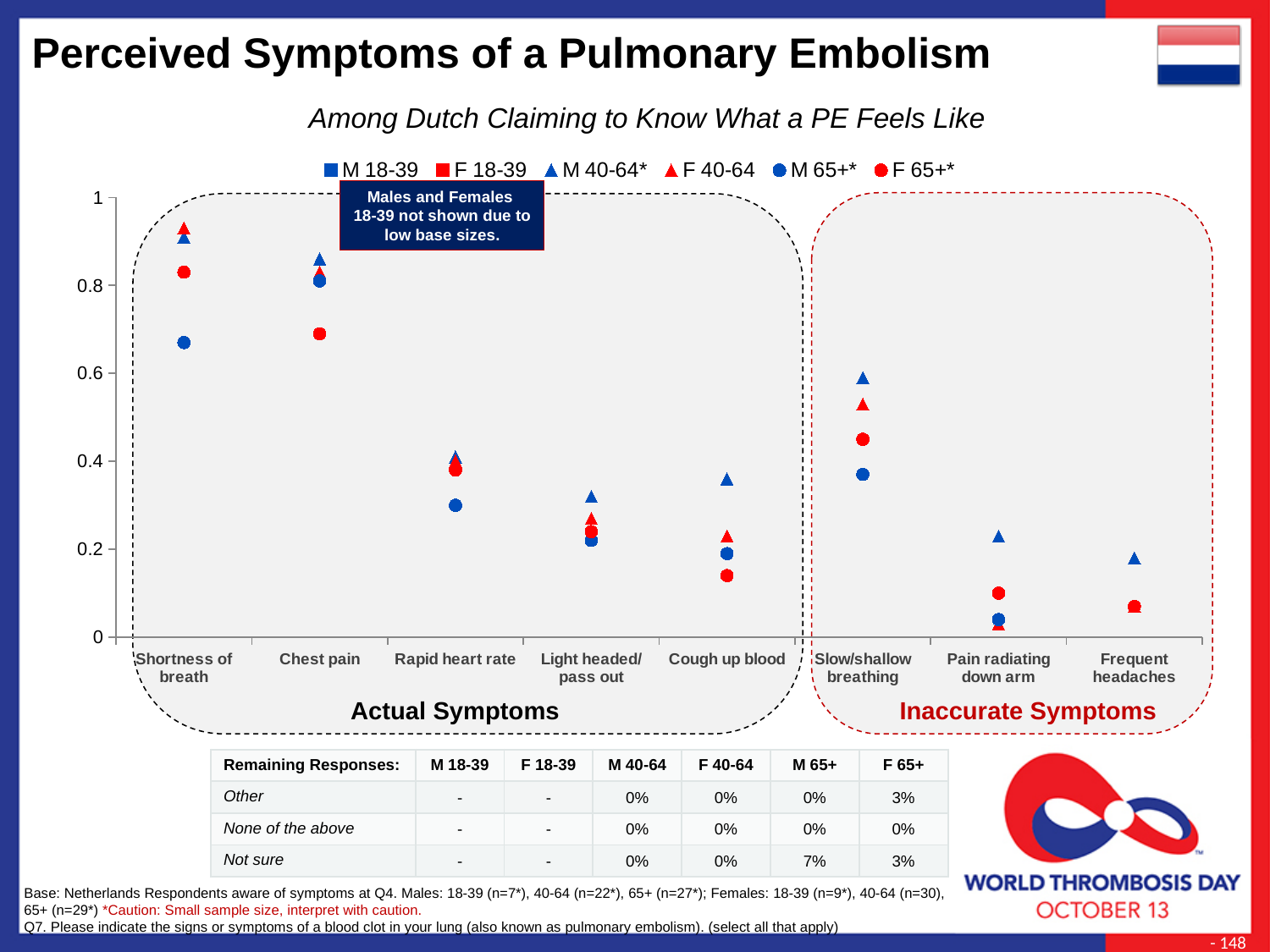
Is the value for M 65+ on Shortness of breath greater or less than 0.8? less Is the value for F 40-64 on Shortness of breath greater or less than 0.8? greater Is the value for F 65+ on Chest pain greater or less than 0.6? greater Which two series are not shown on the chart due to low base sizes? M 18-39 and F 18-39 How many series does the legend list? 6 How many symptom categories are shown on the x axis? 8 What kind of chart is this? Scatter (dot) chart What is the title of the chart? Perceived Symptoms of a Pulmonary Embolism On Slow/shallow breathing, which is larger: the value for M 40-64 or for M 65+? M 40-64 For the F 40-64 series, which symptom has the highest value? Shortness of breath